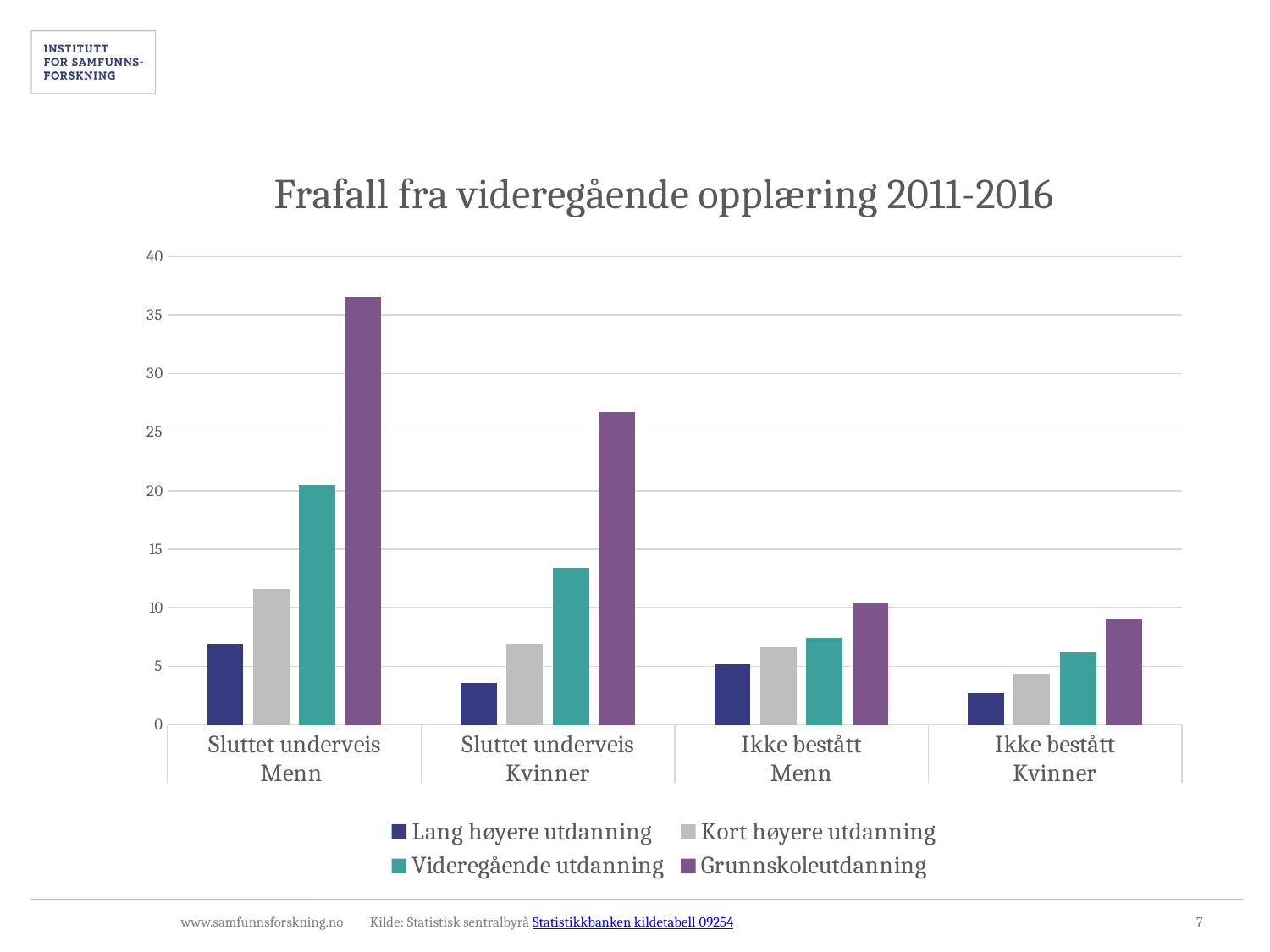
Which colour represents Grunnskoleutdanning in the legend? Purple Which is larger: the Grunnskoleutdanning value for Sluttet underveis Kvinner or for Ikke bestått Menn? Sluttet underveis Kvinner For Ikke bestått Kvinner, which is larger: Lang høyere utdanning or Kort høyere utdanning? Kort høyere utdanning Is the Videregående utdanning value for Sluttet underveis Kvinner greater or less than 15? less Is the Kort høyere utdanning value for Sluttet underveis Menn greater or less than 10? greater What kind of chart is shown on the slide? Bar chart Which category has the lowest Lang høyere utdanning bar? Ikke bestått Kvinner How many categories are shown on the x axis of the chart? 4 How many series does the legend list? 4 What is the title of the chart? Frafall fra videregående opplæring 2011-2016 Is the Grunnskoleutdanning value for Sluttet underveis Menn greater or less than 35? greater Which category has the highest Grunnskoleutdanning bar? Sluttet underveis Menn